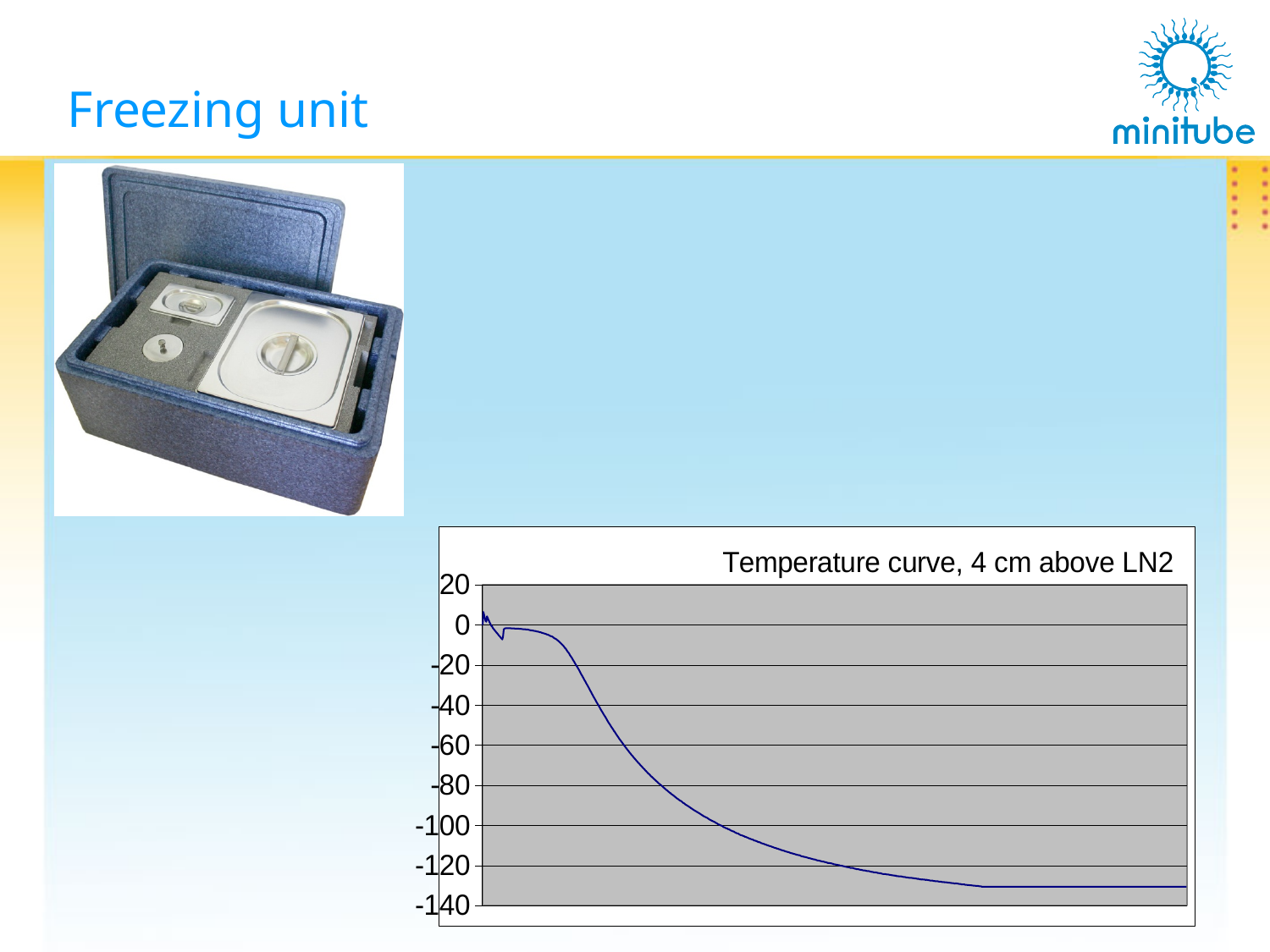
Do the values in the Temperature curve chart rise or fall along the x axis overall? fall In the Temperature curve chart, is the value at the right end of the curve greater or less than -120? less In the Temperature curve chart, is the value at the start of the curve greater or less than -20? greater What is the title of the chart on the slide? Temperature curve, 4 cm above LN2 In the Temperature curve chart, is the value at the right end of the curve greater or less than -140? greater What is the lowest tick value shown on the y axis of the Temperature curve chart? -140 What kind of chart is shown on the slide? line chart